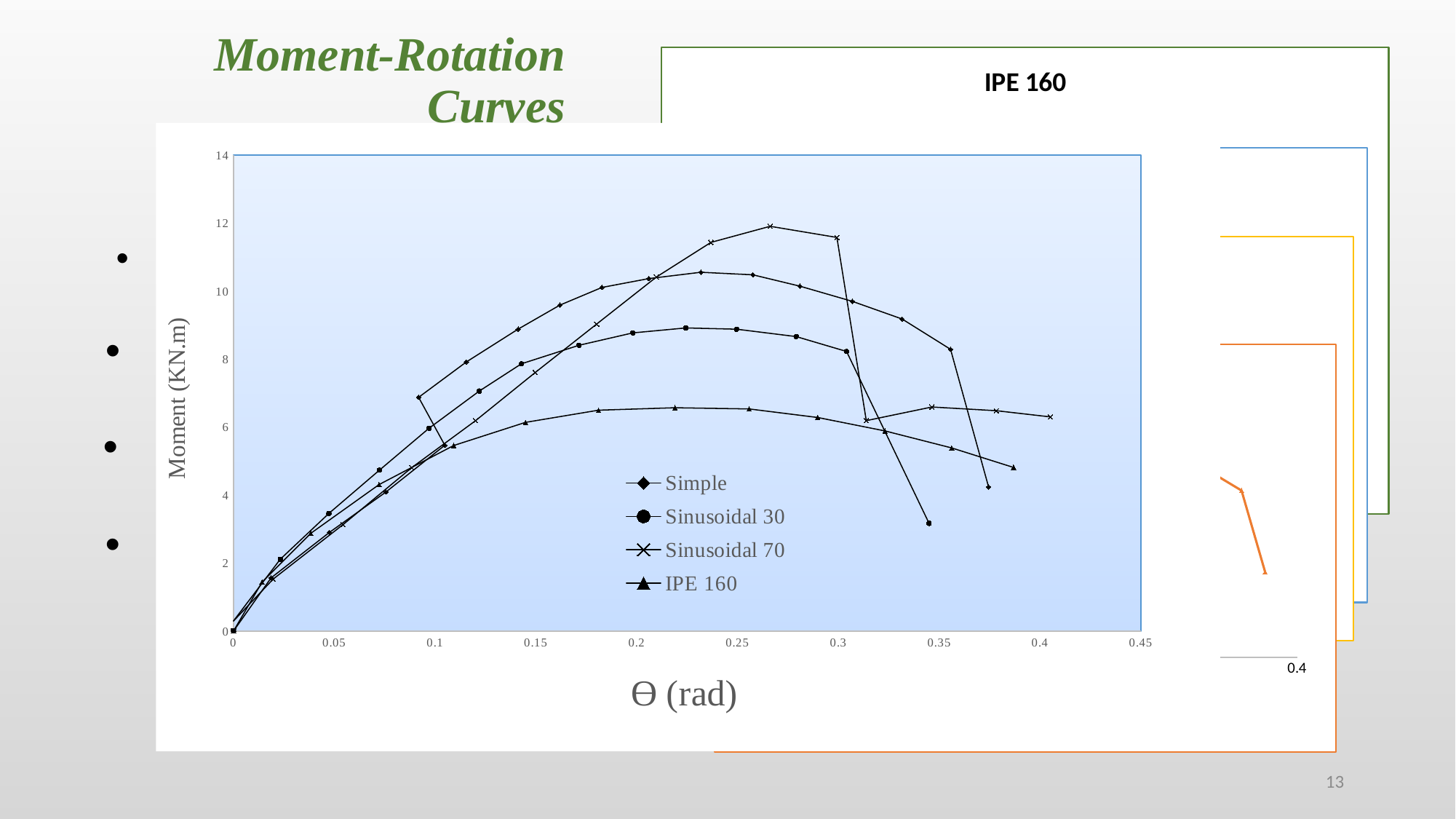
Is the peak value of the Simple series greater or less than 10? greater Which series has the lowest peak moment value on the chart? IPE 160 What is the label of the vertical axis of the chart? Moment (KN.m) How many series does the chart legend list? 4 Which series are listed in the chart legend? Simple, Sinusoidal 30, Sinusoidal 70, IPE 160 Is the peak value of the Sinusoidal 70 series greater or less than 10? greater Is the peak value of the Sinusoidal 30 series greater or less than 10? less Does the IPE 160 series rise or fall along the x axis after about 0.25 rad? fall Which series reaches the highest moment value on the chart? Sinusoidal 70 Which series has a higher peak moment, Simple or Sinusoidal 30? Simple What kind of chart is shown on the slide? line chart